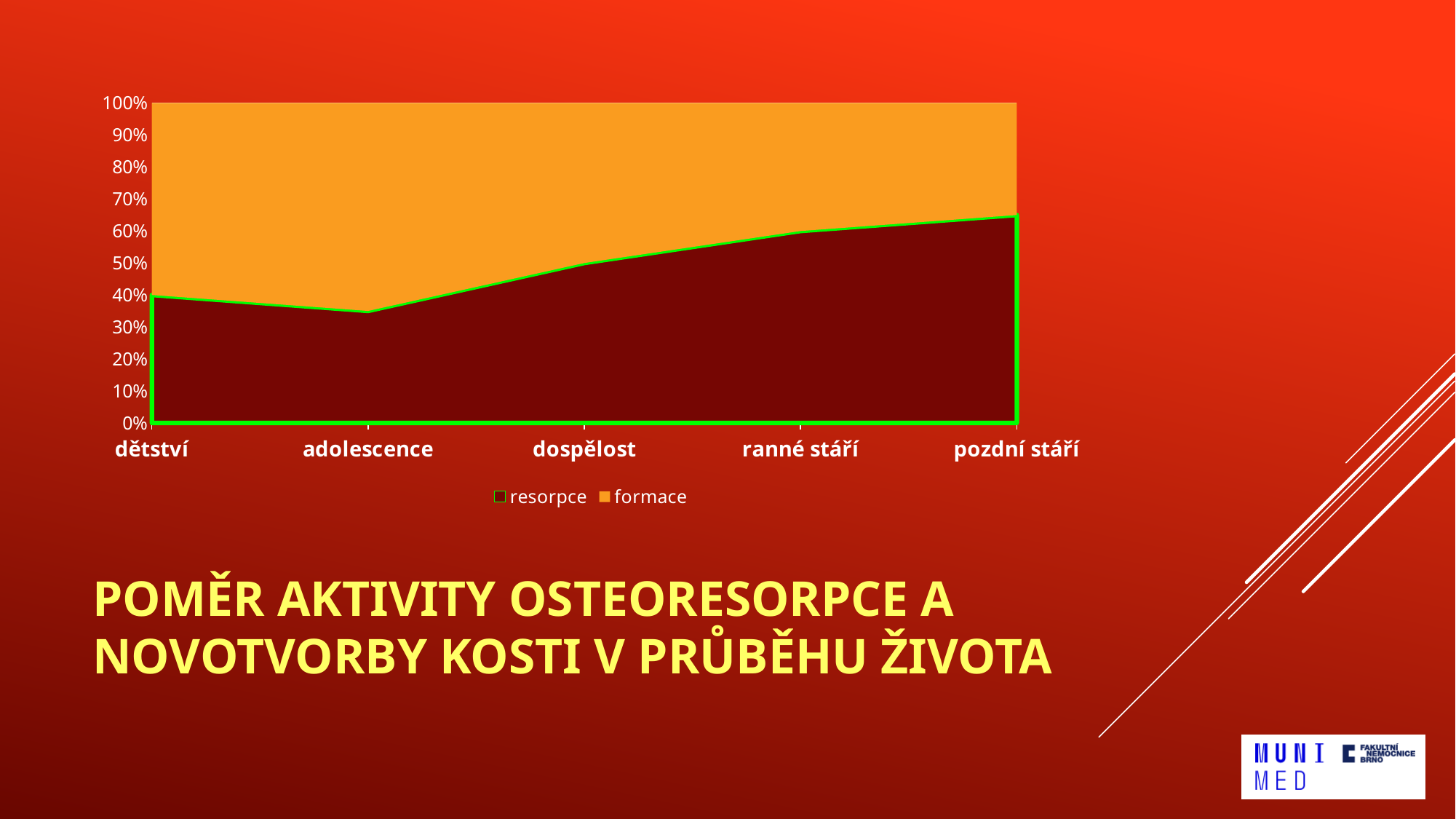
At dětství, which series has the larger share, resorpce or formace? formace At pozdní stáří, which series has the larger share, resorpce or formace? resorpce What are the two series named in the legend? resorpce and formace From adolescence to pozdní stáří, does the share of resorpce rise or fall? rises Is the share of formace at dětství greater or less than 50%? greater Is the share of resorpce at pozdní stáří greater or less than 60%? greater In which category is the share of resorpce lowest? adolescence Is the share of resorpce at adolescence greater or less than 40%? less How many life-stage categories are shown along the x axis? 5 How many series does the chart legend list? 2 In which category is the share of resorpce highest? pozdní stáří What kind of chart is shown on the slide? Stacked area chart